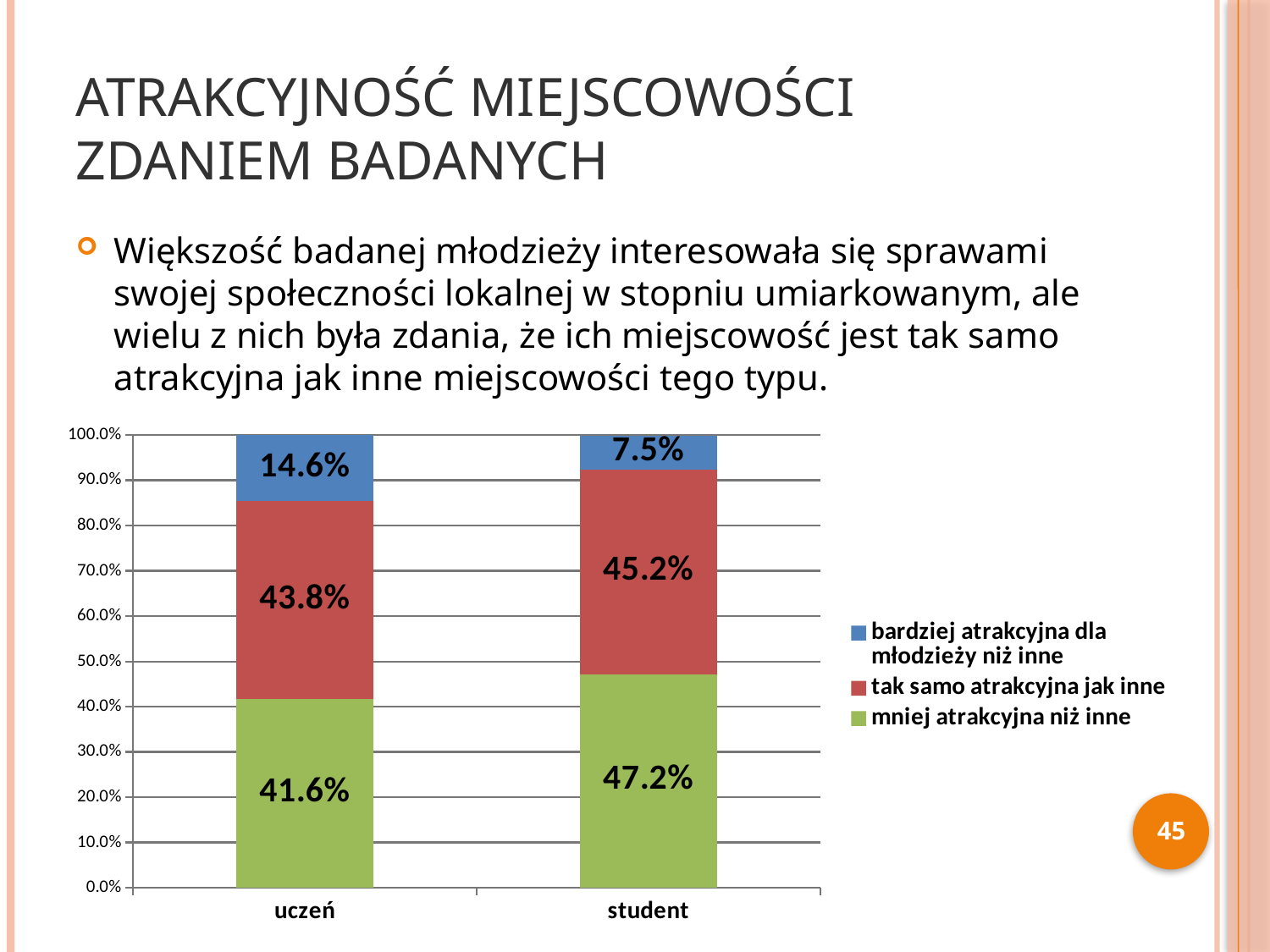
How many categories are shown on the x axis of the chart? 2 What is the value of "mniej atrakcyjna niż inne" for student? 47.2% Which category has the higher value for "bardziej atrakcyjna dla młodzieży niż inne", uczeń or student? uczeń What is the value of "bardziej atrakcyjna dla młodzieży niż inne" for student? 7.5% What kind of chart is shown on the slide? stacked bar chart What is the value of "bardziej atrakcyjna dla młodzieży niż inne" for uczeń? 14.6% What is the value of "tak samo atrakcyjna jak inne" for uczeń? 43.8% Which category has the higher value for "mniej atrakcyjna niż inne", uczeń or student? student What is the difference between the "mniej atrakcyjna niż inne" values for student and uczeń? 5.6% How many series does the chart's legend list? 3 Which series is shown in green in the chart? mniej atrakcyjna niż inne What is the difference between the "bardziej atrakcyjna dla młodzieży niż inne" values for uczeń and student? 7.1%